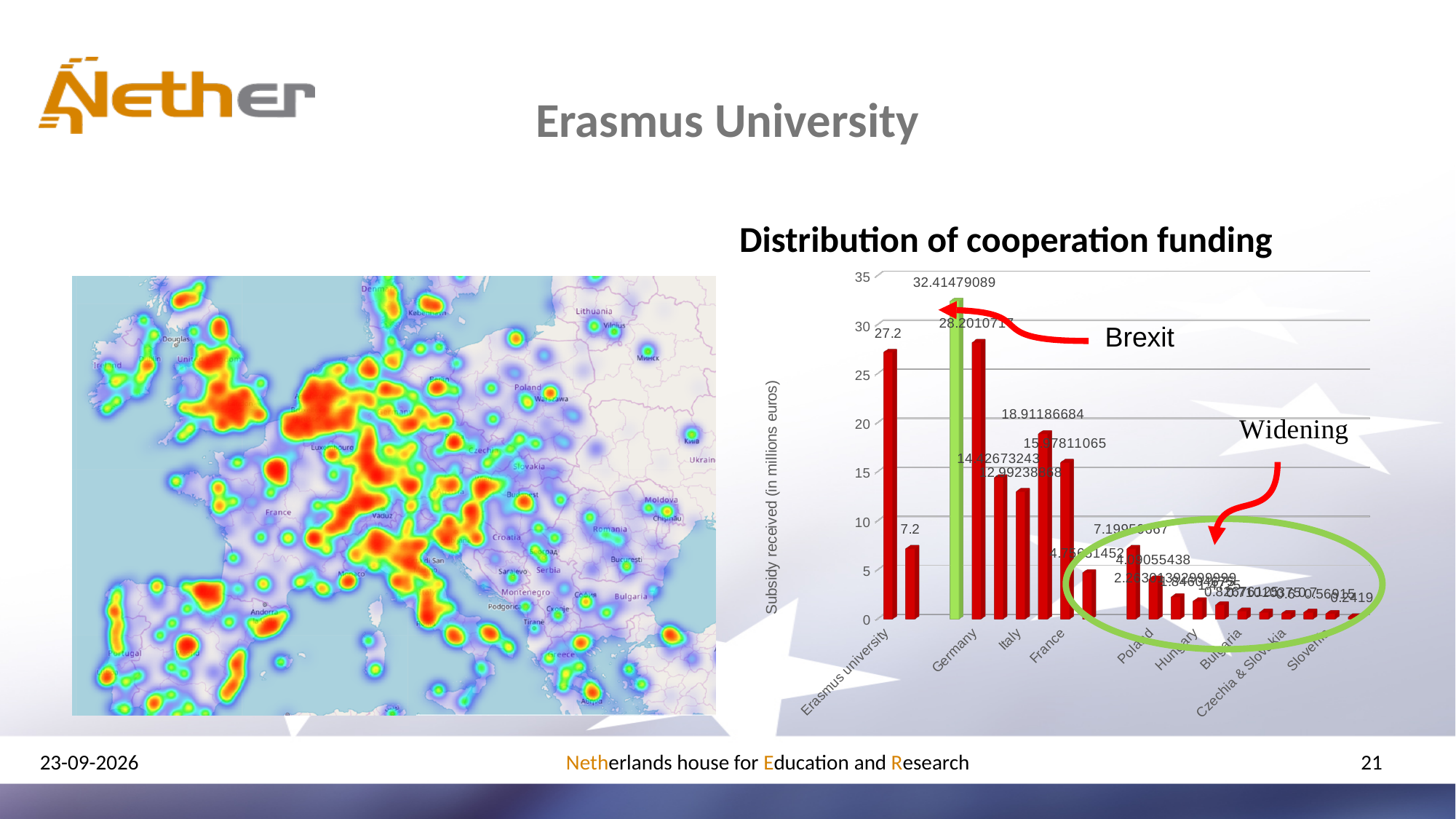
What is the label of the vertical axis of the chart? Subsidy received (in millions euros) What kind of chart is shown under the title 'Distribution of cooperation funding'? bar chart What is the title of the chart on the right of the slide? Distribution of cooperation funding Is the value for Erasmus university greater or less than 25? greater What value is shown for Erasmus university in the chart? 27.2 Which is larger in the chart, the value for Germany or the value for France? Germany Is the value for Poland greater or less than 5? less What is the lowest value labelled on any bar in the chart? 0.2419 What is the highest value labelled on any bar in the chart? 32.41479089 Is the value for Italy greater or less than 15? less